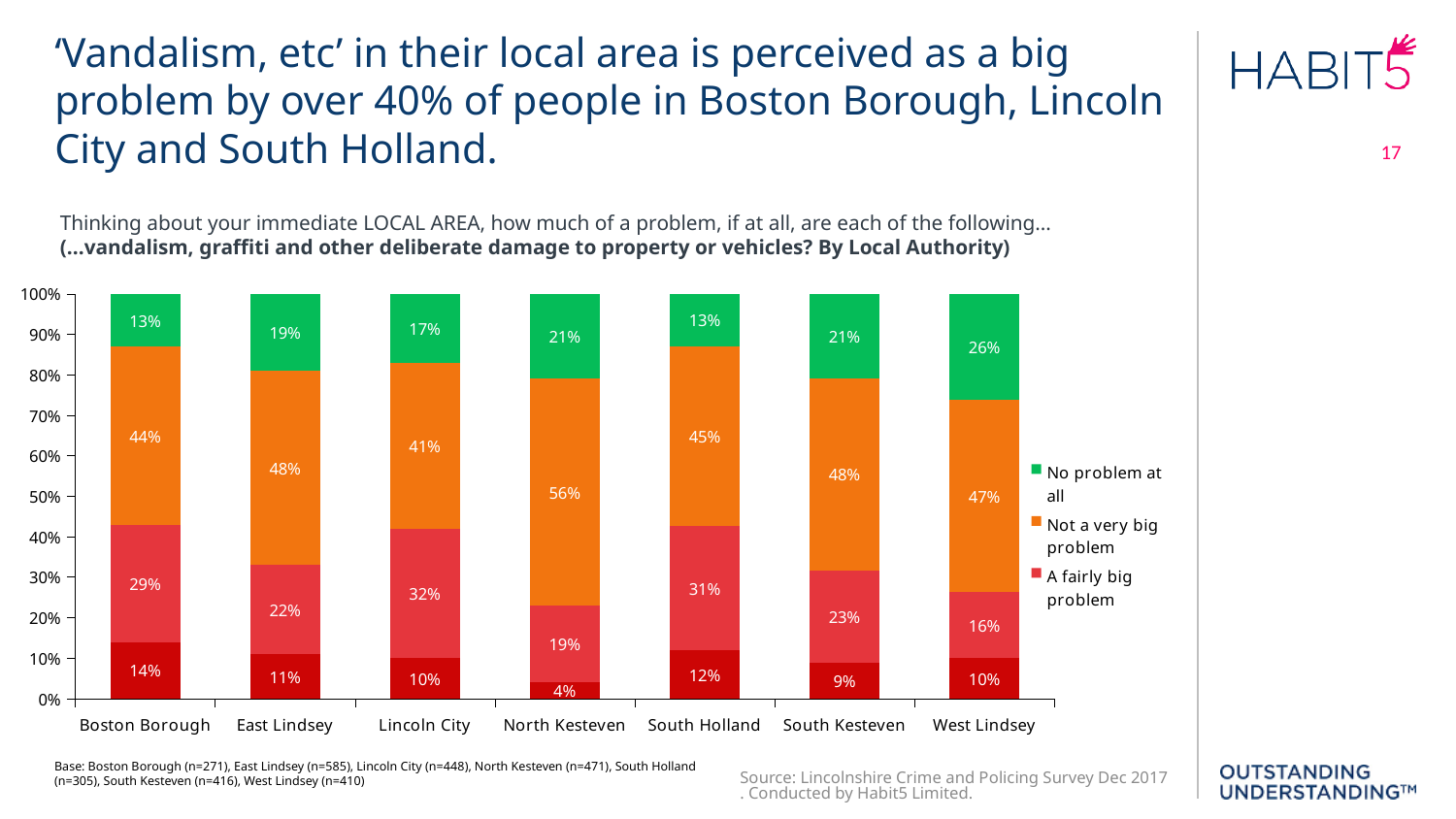
Which local authority has the highest share of 'A fairly big problem' responses? Lincoln City What percentage of people in North Kesteven said vandalism is 'Not a very big problem'? 56% What percentage of people in West Lindsey said vandalism is 'No problem at all'? 26% Which has a larger 'Not a very big problem' share, East Lindsey or Lincoln City? East Lindsey What is the difference in percentage points between the 'A fairly big problem' share for Lincoln City and for East Lindsey? 10 percentage points How many series does the chart's legend list? 3 Which legend entry is shown in green? No problem at all Which local authority has the lowest share of 'A fairly big problem' responses? West Lindsey What percentage of people in Boston Borough said vandalism is 'Not a very big problem'? 44% How many local authorities are shown on the x axis of the chart? 7 What kind of chart is shown on the slide? Stacked bar chart Which local authority has the highest share of 'No problem at all' responses? West Lindsey